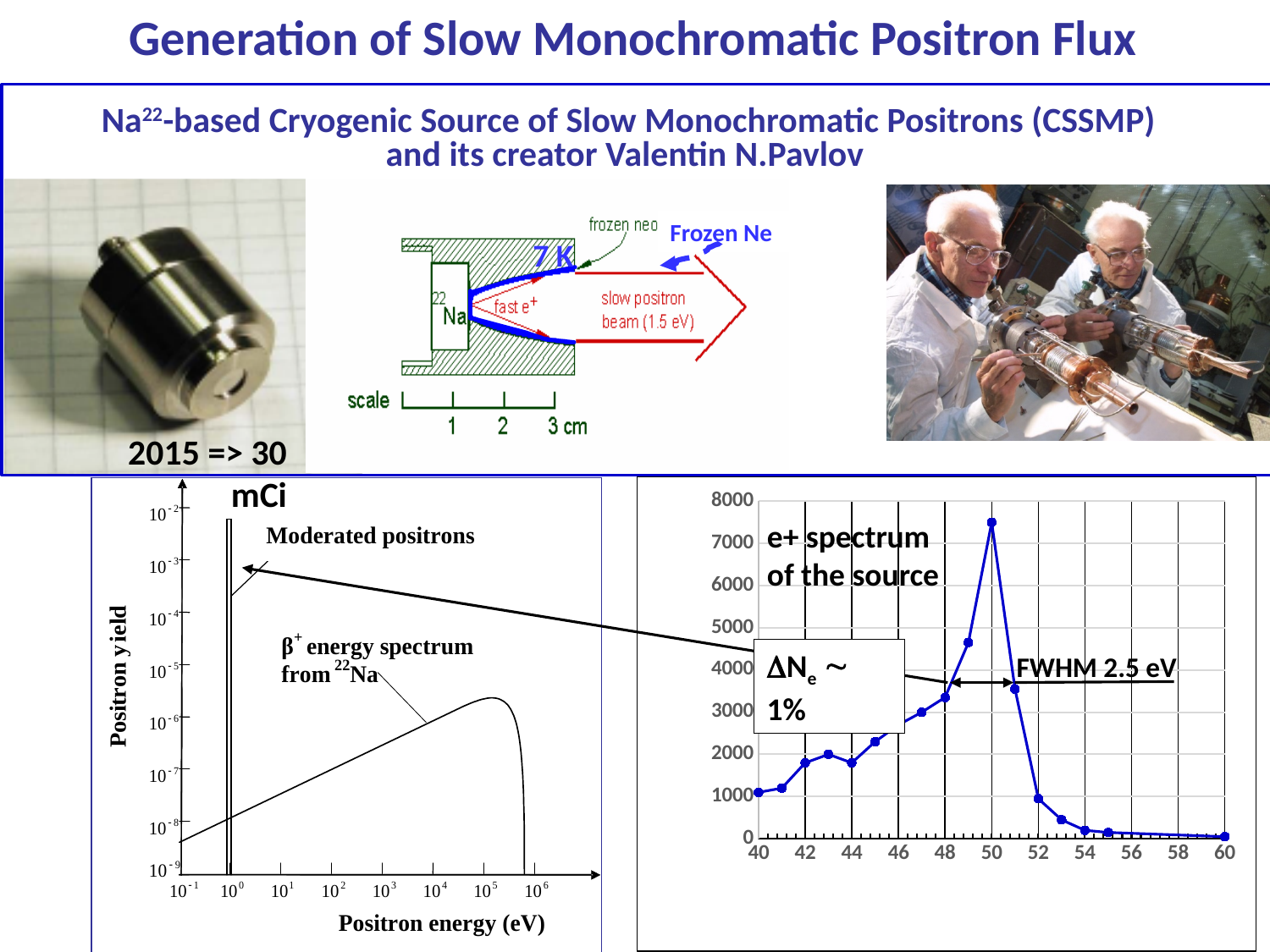
In the right-hand chart 'e+ spectrum of the source', do the values rise or fall as x goes from 50 to 60? fall In the right-hand chart 'e+ spectrum of the source', is the value at x = 49 greater or less than 4000? greater In the left-hand chart, what is the label of the x axis? Positron energy (eV) What kind of chart is the right-hand chart titled 'e+ spectrum of the source'? line chart In the left-hand chart, is the peak of the 'β+ energy spectrum from 22Na' curve greater or less than 10^-5 positron yield? less In the right-hand chart 'e+ spectrum of the source', is the value at x = 44 greater or less than 2000? less In the left-hand chart, which curve reaches the higher positron yield: 'Moderated positrons' or 'β+ energy spectrum from 22Na'? Moderated positrons In the right-hand chart 'e+ spectrum of the source', at which x-axis value does the curve reach its highest point? 50 In the right-hand chart 'e+ spectrum of the source', which is larger: the value at x = 48 or the value at x = 52? x = 48 In the right-hand chart 'e+ spectrum of the source', what FWHM value is annotated on the peak? 2.5 eV